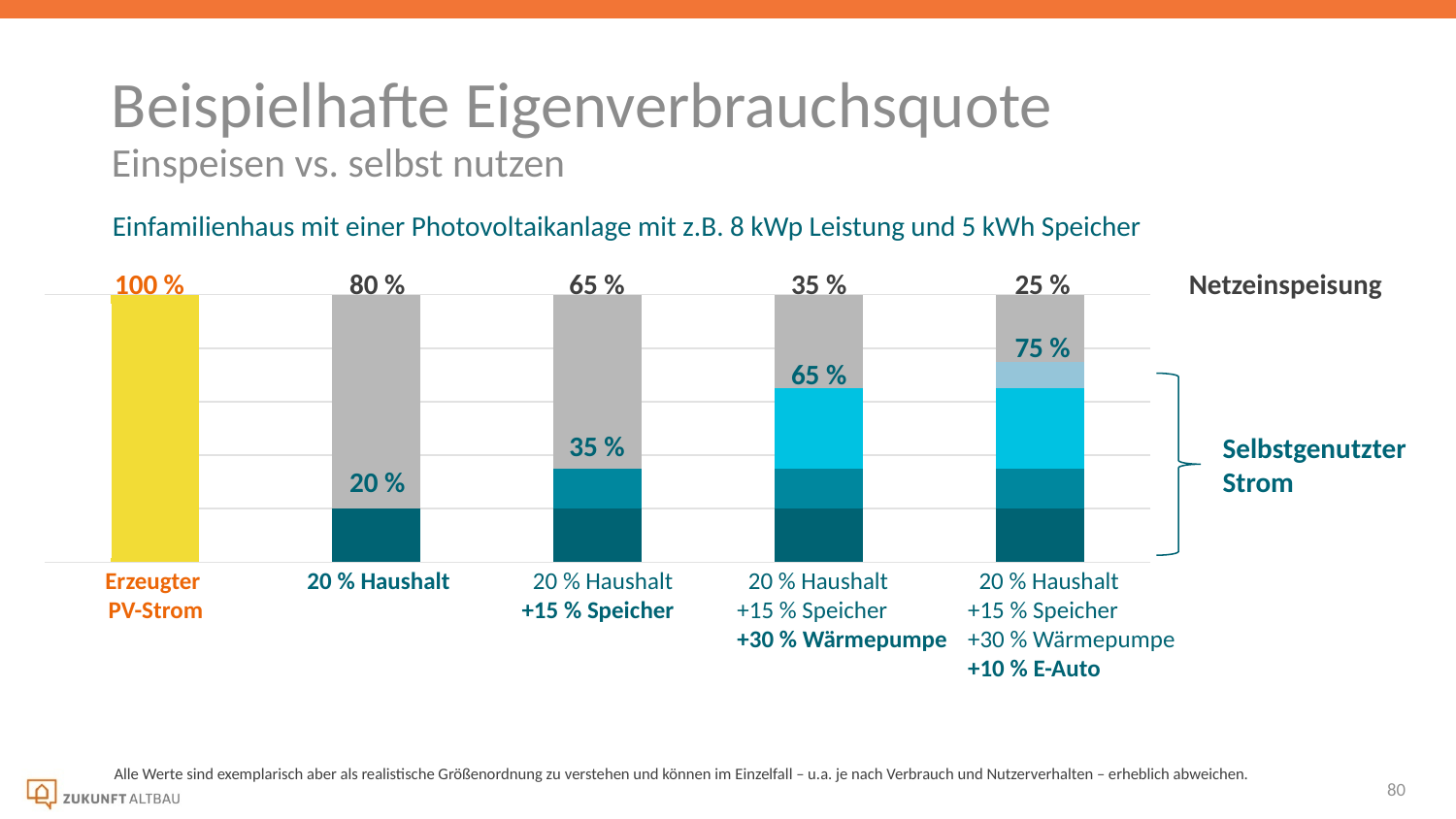
What share of Selbstgenutzter Strom is shown for the bar with 20 % Haushalt + 15 % Speicher? 35 % What is the difference between the Selbstgenutzter Strom share of the bar with +30 % Wärmepumpe (65 %) and the bar with only 20 % Haushalt (20 %)? 45 % Which bar has the lowest Netzeinspeisung value? 20 % Haushalt + 15 % Speicher + 30 % Wärmepumpe + 10 % E-Auto What is the Netzeinspeisung value for the bar that includes +10 % E-Auto? 25 % What is the Netzeinspeisung value for the bar with 20 % Haushalt + 15 % Speicher + 30 % Wärmepumpe? 35 % What is the Netzeinspeisung value for the bar with 20 % Haushalt + 15 % Speicher? 65 % What is the Netzeinspeisung value for the bar labelled '20 % Haushalt'? 80 % What share of Selbstgenutzter Strom is shown for the bar that includes +10 % E-Auto? 75 % What kind of chart is shown on the slide? stacked bar chart How many bars are shown in the chart? 5 What value is shown for the Erzeugter PV-Strom bar? 100 % Does the Netzeinspeisung share rise or fall as more consumers are added from left to right? fall